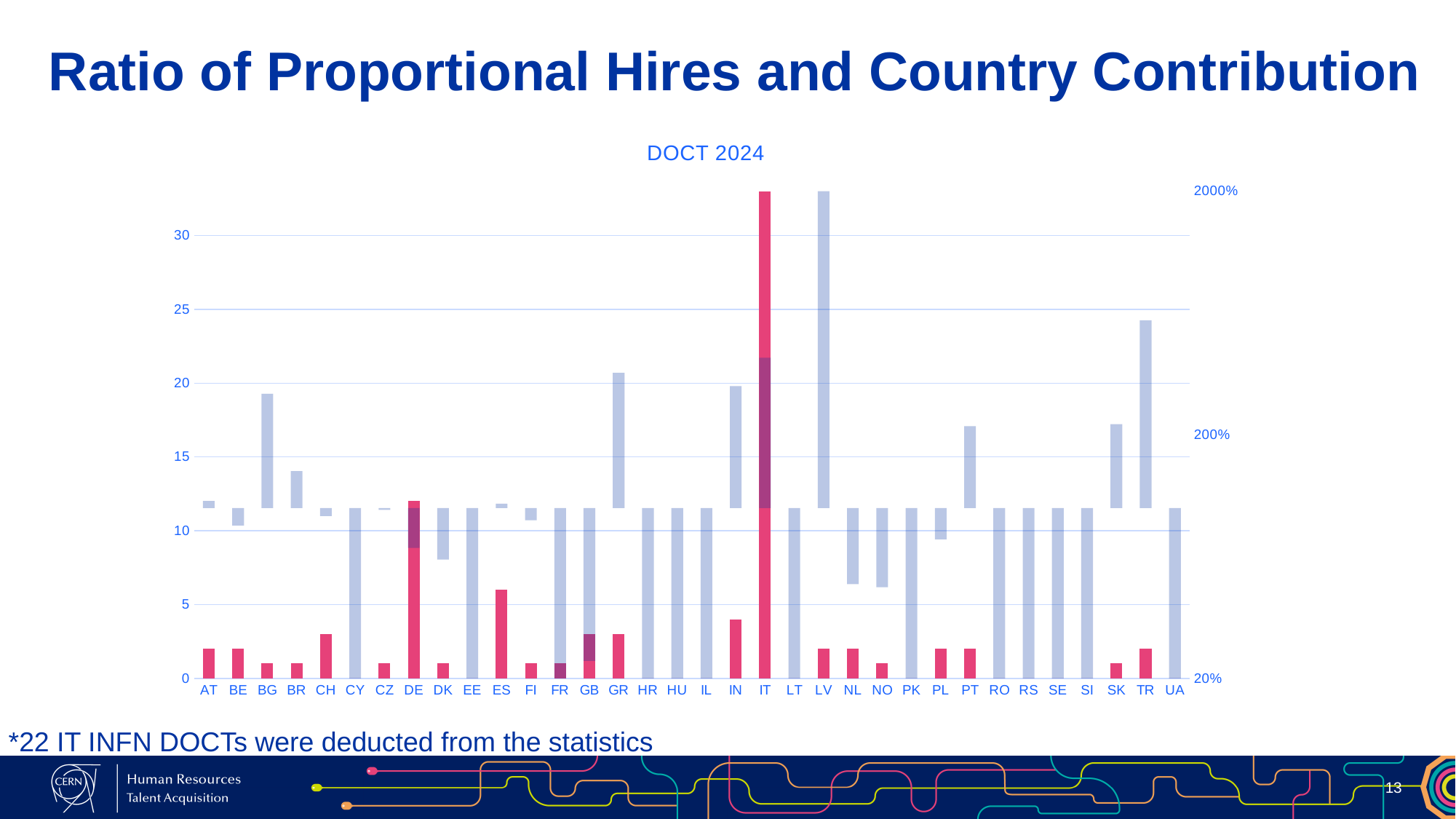
Is the pink bar for IT greater or less than 30 on the left axis? greater Which has the taller pink bar, DE or ES? DE Is the pink bar for DE greater or less than 10 on the left axis? greater Is the light blue bar for NL greater or less than 200% on the right axis? less What is the title of the chart? DOCT 2024 Which country has the tallest light blue bar in the chart? LV What kind of chart is shown on the slide? bar chart How many countries are shown on the x axis of the chart? 34 Which country has the tallest pink bar in the chart? IT What is the highest value labelled on the right-hand axis of the chart? 2000%